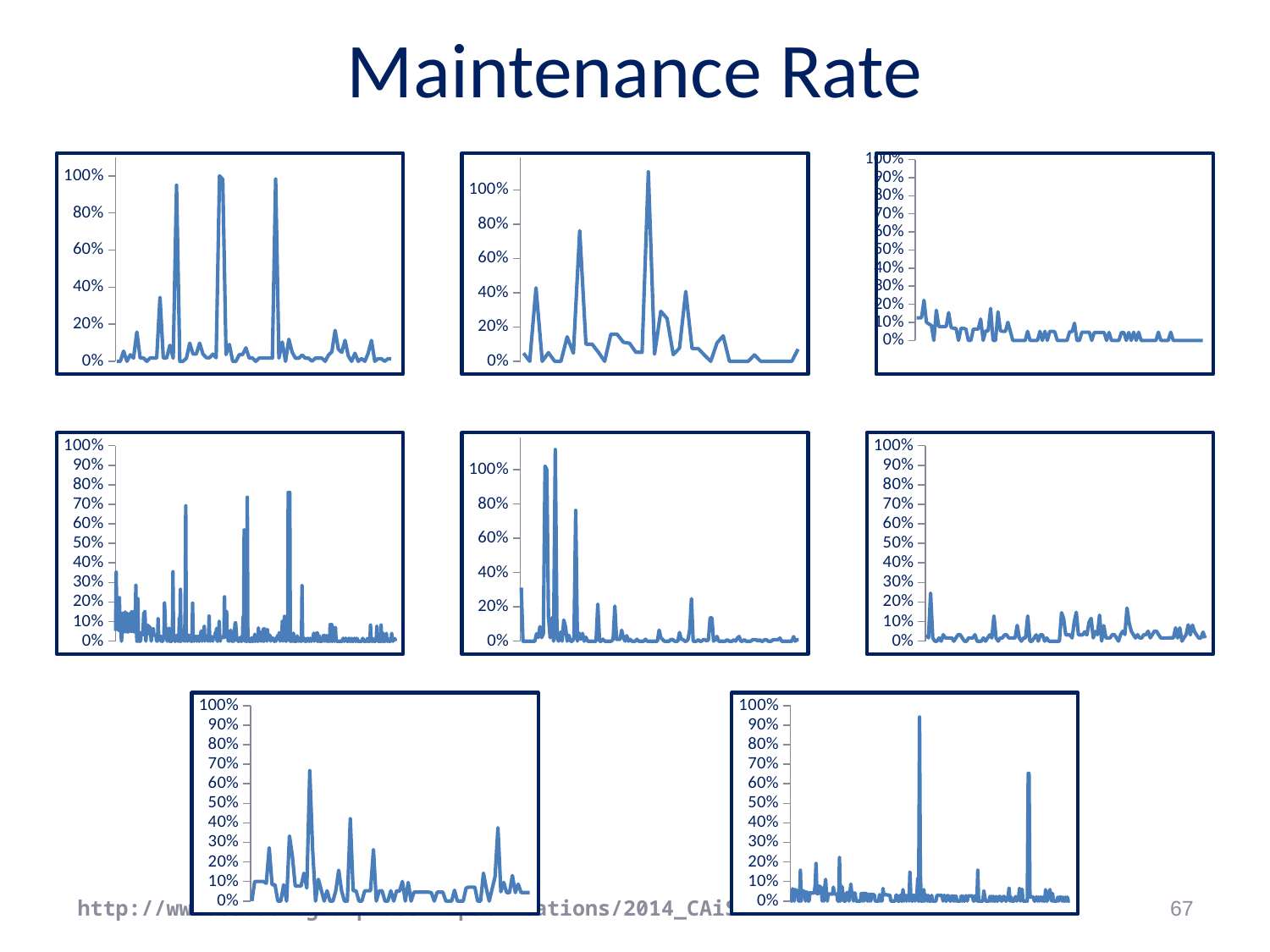
In the top-left chart, is the highest peak greater or less than 80%? greater What is the interval between the y-axis tick labels on the top-left chart? 20% In the middle-left chart, is the highest peak greater or less than 60%? greater How many lines are plotted in the bottom-right chart? 1 What is the title of the slide? Maintenance Rate In the bottom-left chart, is the highest peak greater or less than 50%? greater How many charts are shown on the slide? 8 What kind of chart is the top-left chart on the slide? line chart